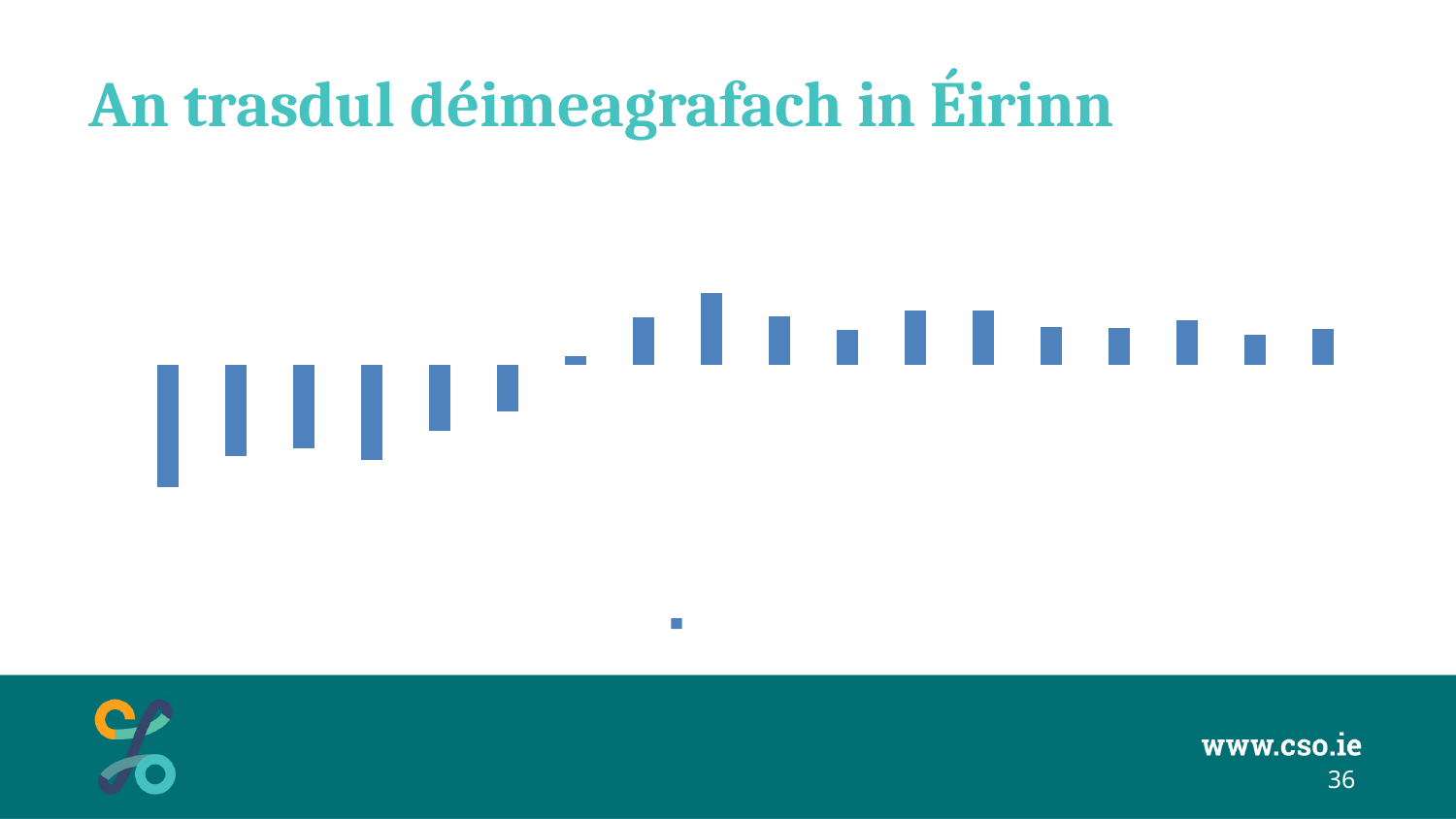
What is the title of the slide containing the chart? An trasdul déimeagrafach in Éirinn How many bars extend below the baseline? 6 What colour are the bars in the chart? blue Which is larger, the eighth bar from the left or the last bar on the right? the eighth bar Counting from the left, which bar extends furthest above the baseline? the ninth bar How many bars are plotted in the chart? 18 Is the first bar from the left above or below the baseline? below What kind of chart is shown on the slide? bar chart Counting from the left, which bar extends furthest below the baseline? the first bar How many bars extend above the baseline? 12 Do the bars rise or fall from the first bar to the eighth bar along the x axis? rise How many series does the chart's legend show? 1